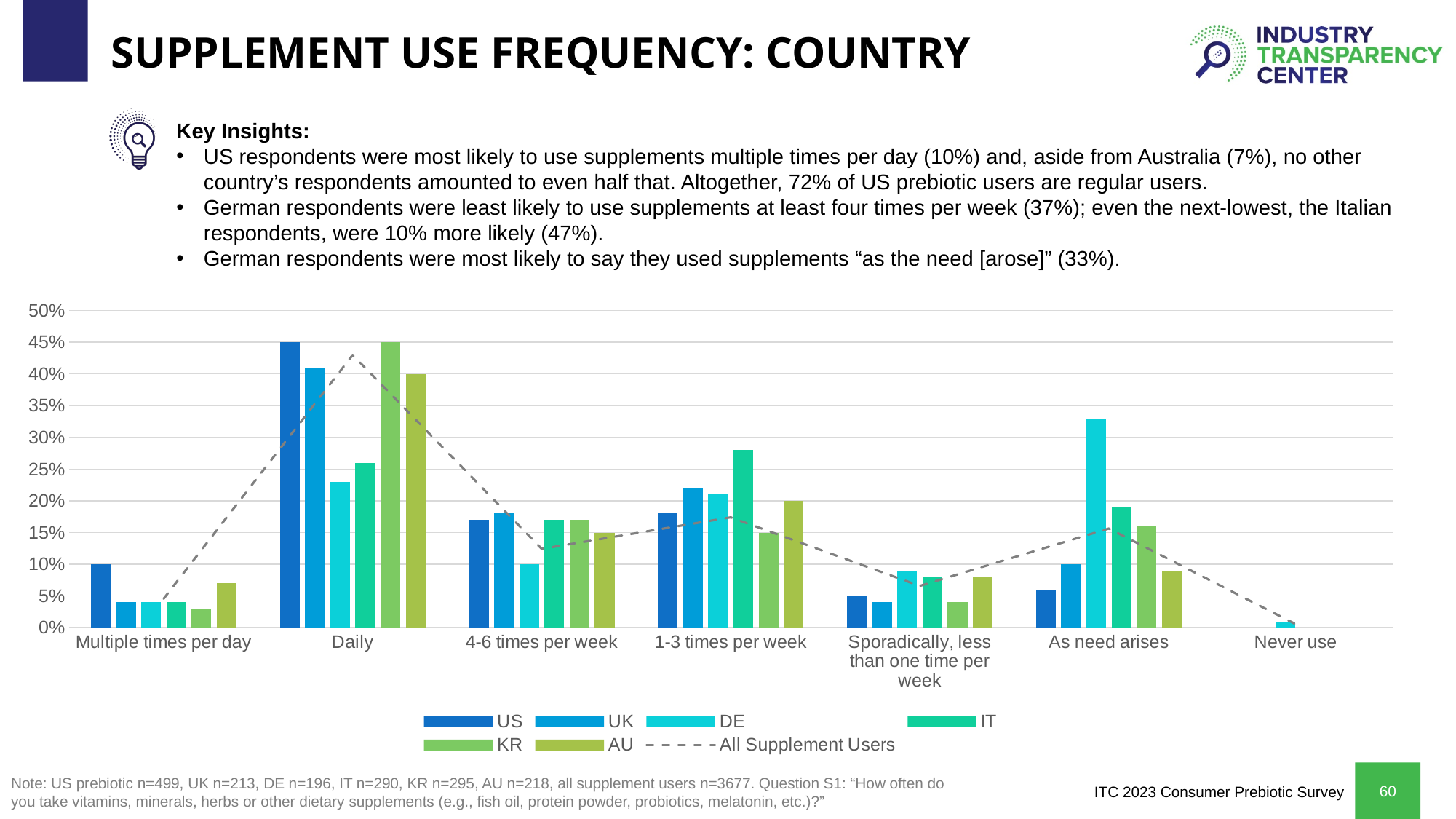
In the 'Daily' category, which is larger, the US bar or the UK bar? US How many series does the chart's legend list? 7 Is the value for DE in the 'As need arises' category greater or less than 30%? greater What is the value for AU in the 'Daily' category? 40% Which country has the highest bar in the 'As need arises' category? DE What is the value for US in the 'Multiple times per day' category? 10% What is the value for AU in the '1-3 times per week' category? 20% Is the value for IT in the '1-3 times per week' category greater or less than 25%? greater What kind of chart is shown on the slide? combination bar and line chart Which series is drawn as a dashed line in the chart? All Supplement Users How many frequency categories are shown along the x axis of the chart? 7 Which country has the lowest bar in the 'Daily' category? DE